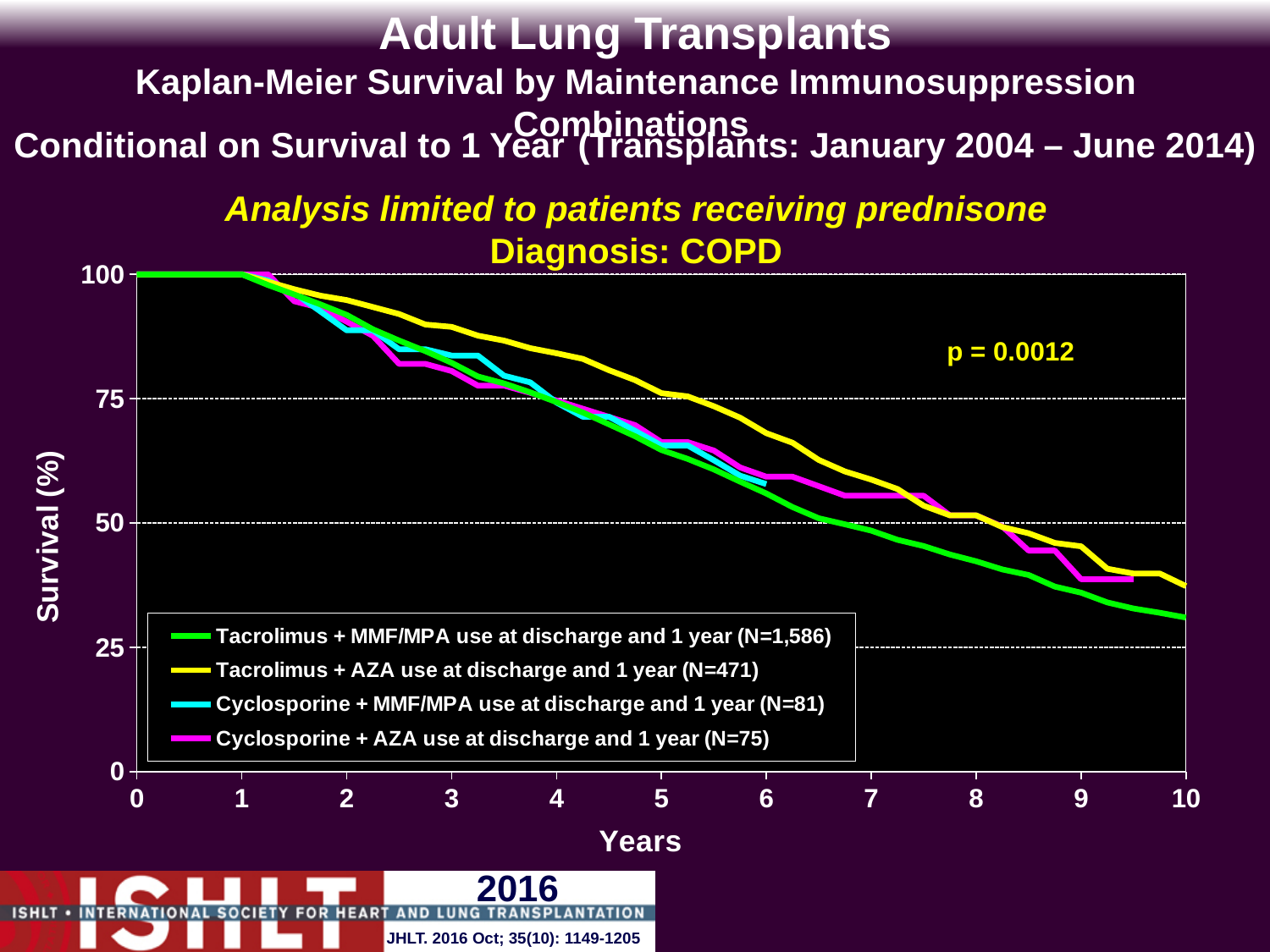
Is the survival value for Tacrolimus + MMF/MPA at 8 years greater or less than 50? less How many series does the legend list? 4 Is the survival value for Tacrolimus + AZA at 10 years greater or less than 50? less Is the survival value for Tacrolimus + AZA at 4 years greater or less than 75? greater What p-value is shown on the chart? p = 0.0012 What kind of chart is shown on the slide? line chart At 6 years, which series has the highest survival? Tacrolimus + AZA use at discharge and 1 year At 3 years, which has higher survival: Tacrolimus + AZA or Tacrolimus + MMF/MPA? Tacrolimus + AZA Do the survival curves rise or fall as years increase? fall What is the N for the Tacrolimus + MMF/MPA group in the legend? N=1,586 At 8 years, which has higher survival: Tacrolimus + AZA or Tacrolimus + MMF/MPA? Tacrolimus + AZA